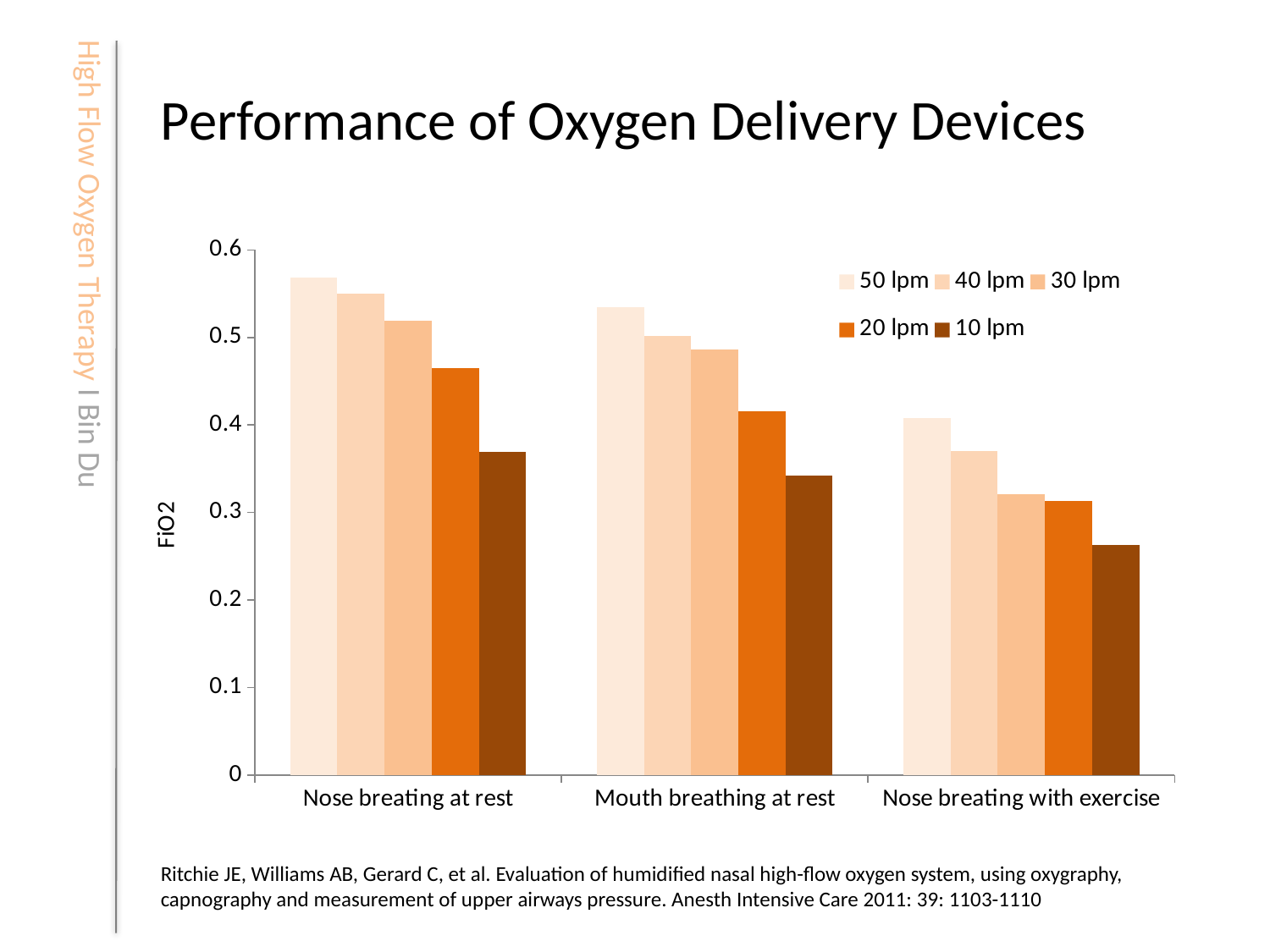
Within the 'Nose breating at rest' category, which flow rate gives the highest FiO2? 50 lpm What is the label of the y axis? FiO2 What is the title of the chart on the slide? Performance of Oxygen Delivery Devices How many series does the chart's legend list? 5 Is the 10 lpm value for 'Nose breating with exercise' greater or less than 0.3? less Is the 50 lpm value for 'Nose breating at rest' greater or less than 0.5? greater Which is larger: the 50 lpm value for 'Nose breating at rest' or the 50 lpm value for 'Nose breating with exercise'? Nose breating at rest How many categories are shown on the x axis of the chart? 3 Which category has the lowest FiO2 value for the 10 lpm series? Nose breating with exercise Which category has the highest FiO2 value for the 50 lpm series? Nose breating at rest Is the 10 lpm value for 'Mouth breathing at rest' greater or less than 0.4? less What kind of chart is shown on the slide? bar chart